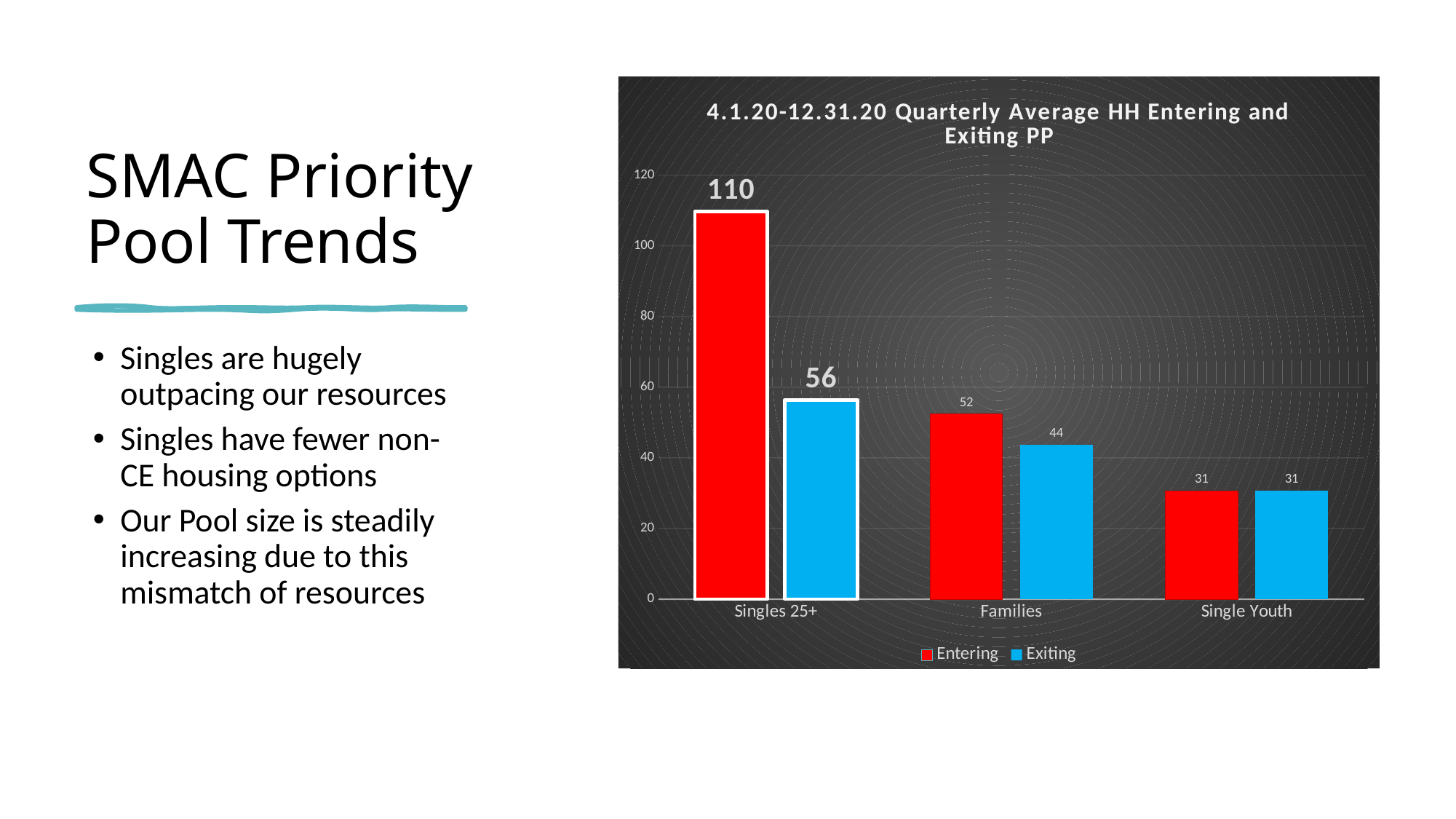
What is the difference between the Entering values for Families and Single Youth? 21 What is the Exiting value for Families? 44 Which category has the lowest Exiting value? Single Youth How many categories are shown on the x axis? 3 Which category has the highest Entering value? Singles 25+ Which is larger, the Entering value for Families or the Exiting value for Singles 25+? Exiting value for Singles 25+ What is the difference between the Entering and Exiting values for Singles 25+? 54 What is the Entering value for Single Youth? 31 What kind of chart is shown on the slide? Bar chart How many series does the legend list? 2 What is the Entering value for Singles 25+? 110 What is the title of the chart? 4.1.20-12.31.20 Quarterly Average HH Entering and Exiting PP